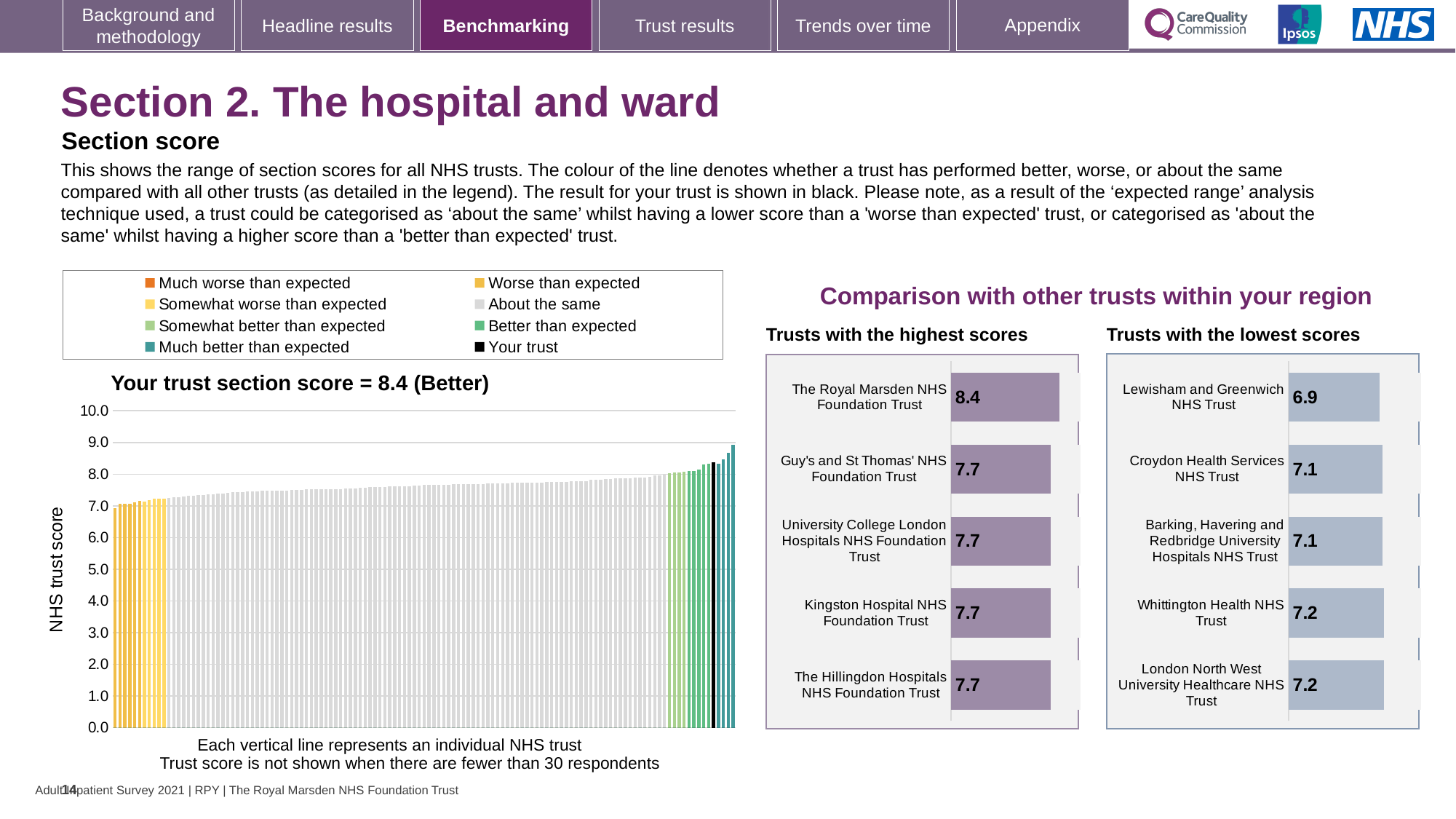
In the 'Your trust section score' chart, do the trust scores rise or fall from left to right? Rise How many trusts are listed in the 'Trusts with the highest scores' chart? 5 In the 'Your trust section score' chart, is the value of the tallest bar greater or less than 8.0? greater In the 'Trusts with the lowest scores' chart, what is the score for Whittington Health NHS Trust? 7.2 In the 'Trusts with the lowest scores' chart, which trust has the lowest score? Lewisham and Greenwich NHS Trust In the 'Trusts with the lowest scores' chart, what is the score for Lewisham and Greenwich NHS Trust? 6.9 In the 'Trusts with the highest scores' chart, what is the difference between the scores of The Royal Marsden NHS Foundation Trust and Guy's and St Thomas' NHS Foundation Trust? 0.7 In the 'Trusts with the highest scores' chart, what is the score for The Royal Marsden NHS Foundation Trust? 8.4 Which is larger: the score for Kingston Hospital NHS Foundation Trust in the 'Trusts with the highest scores' chart or the score for Croydon Health Services NHS Trust in the 'Trusts with the lowest scores' chart? Kingston Hospital NHS Foundation Trust In the 'Trusts with the lowest scores' chart, what is the difference between the scores of Croydon Health Services NHS Trust and Lewisham and Greenwich NHS Trust? 0.2 What kind of chart is the 'Your trust section score' chart on the left? Bar chart In the 'Trusts with the highest scores' chart, which trust has the highest score? The Royal Marsden NHS Foundation Trust